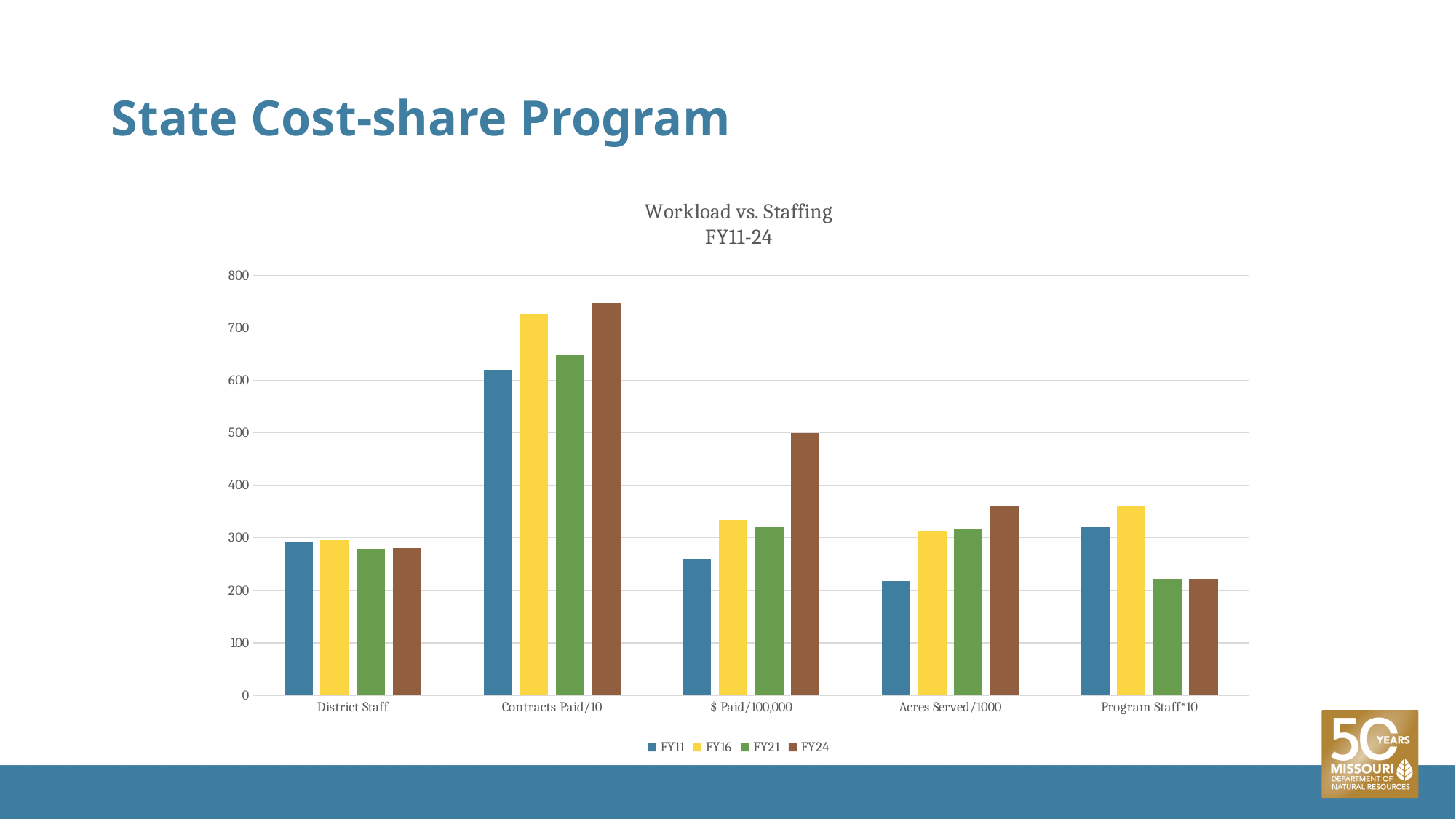
What kind of chart is shown on the slide? Bar chart Which series has the highest value for $ Paid/100,000? FY24 How many categories are shown on the x axis? 5 Which series has the lowest value for Acres Served/1000? FY11 For Program Staff*10, which is larger: FY16 or FY21? FY16 For Contracts Paid/10, which is larger: FY16 or FY21? FY16 What is the title of the chart? Workload vs. Staffing FY11-24 How many series does the legend list? 4 Is the FY24 value for Contracts Paid/10 greater or less than 700? greater Which category has the highest FY24 bar? Contracts Paid/10 Is the FY11 value for $ Paid/100,000 greater or less than 300? less Is the FY11 value for Acres Served/1000 greater or less than 250? less